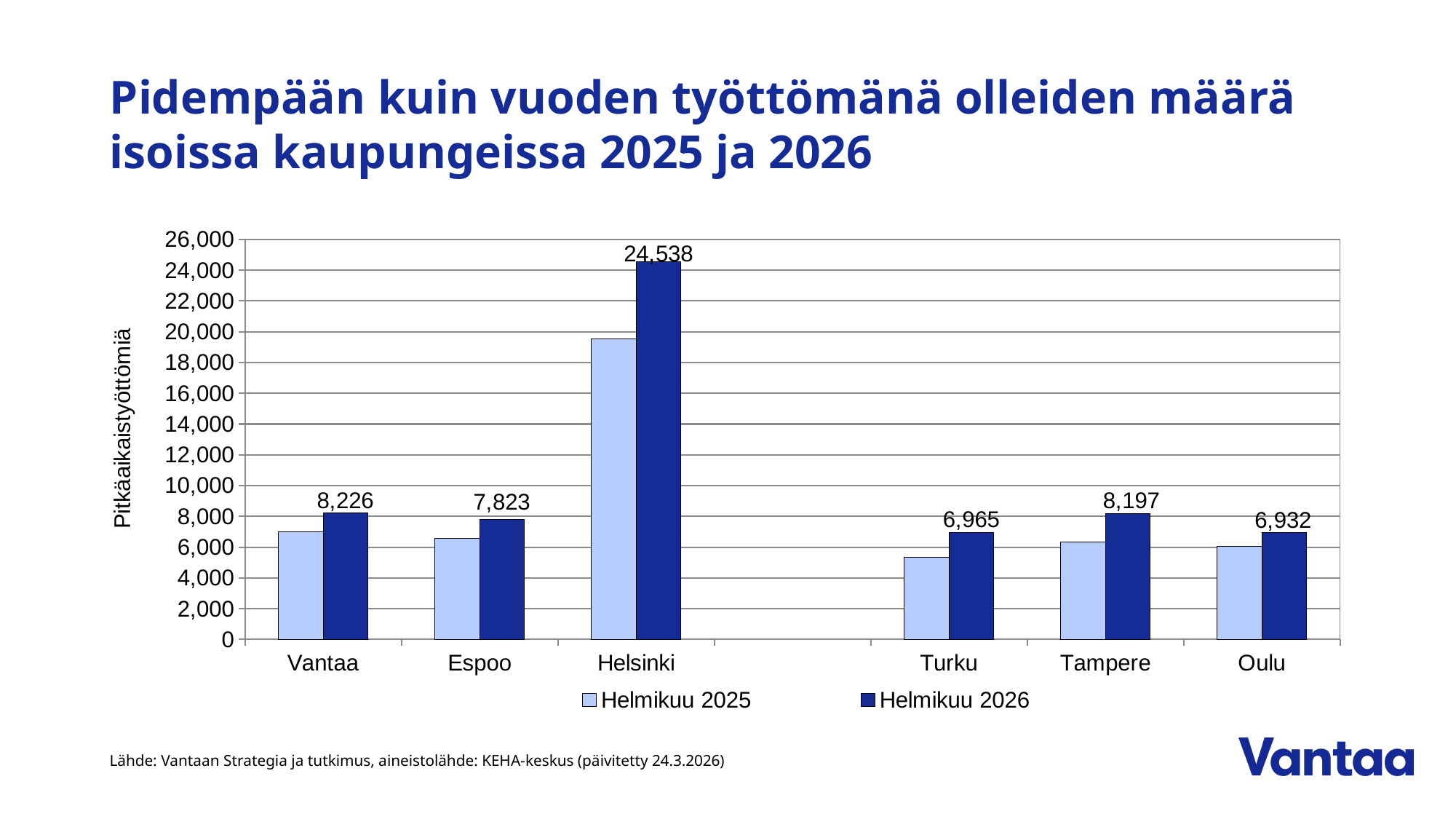
How many cities are shown on the x axis? 6 What is the value for Vantaa in the Helmikuu 2026 series? 8,226 Which city has the lowest value in the Helmikuu 2026 series? Oulu What is the value for Helsinki in the Helmikuu 2026 series? 24,538 Which city has the highest value in the Helmikuu 2026 series? Helsinki Is the Helmikuu 2025 value for Helsinki greater or less than 18,000? greater What is the value for Turku in the Helmikuu 2026 series? 6,965 How many series does the legend list? 2 What kind of chart is shown on the slide? bar chart Is the Helmikuu 2025 value for Vantaa greater or less than 8,000? less Which is larger in the Helmikuu 2026 series, Vantaa or Tampere? Vantaa What is the difference between the Helmikuu 2026 values for Helsinki and Vantaa? 16,312